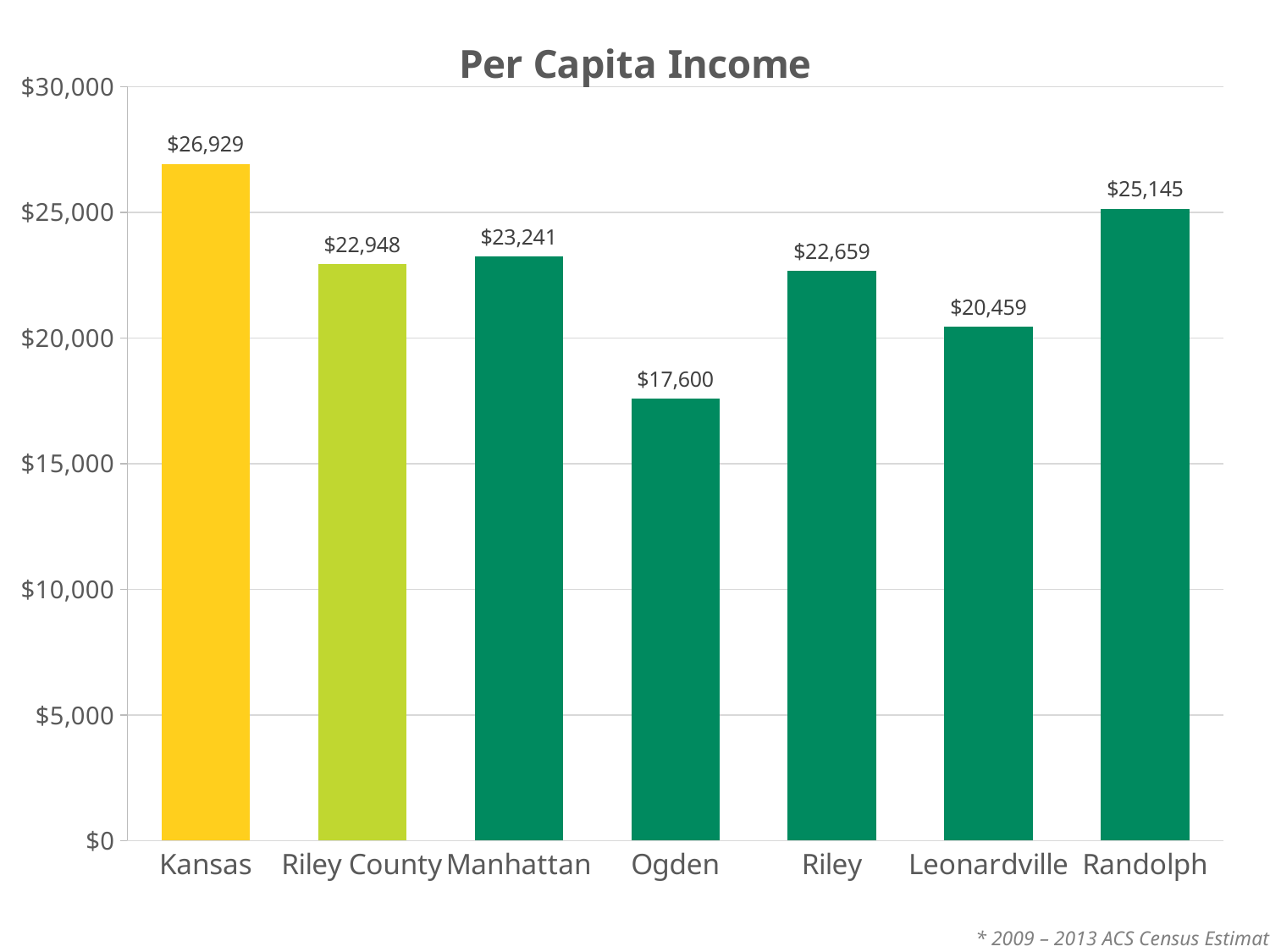
Which category has the highest per capita income? Kansas Is the value for Leonardville greater or less than $20,000? greater What is the per capita income for Leonardville? $20,459 What is the difference between the per capita income of Manhattan and Ogden? $5,641 Which has a higher per capita income, Randolph or Riley? Randolph What is the per capita income for Ogden? $17,600 What kind of chart is this? bar chart What is the per capita income for Kansas? $26,929 What is the title of the chart? Per Capita Income Which category has the lowest per capita income? Ogden How many categories are shown on the chart? 7 What is the difference between the per capita income of Kansas and Randolph? $1,784